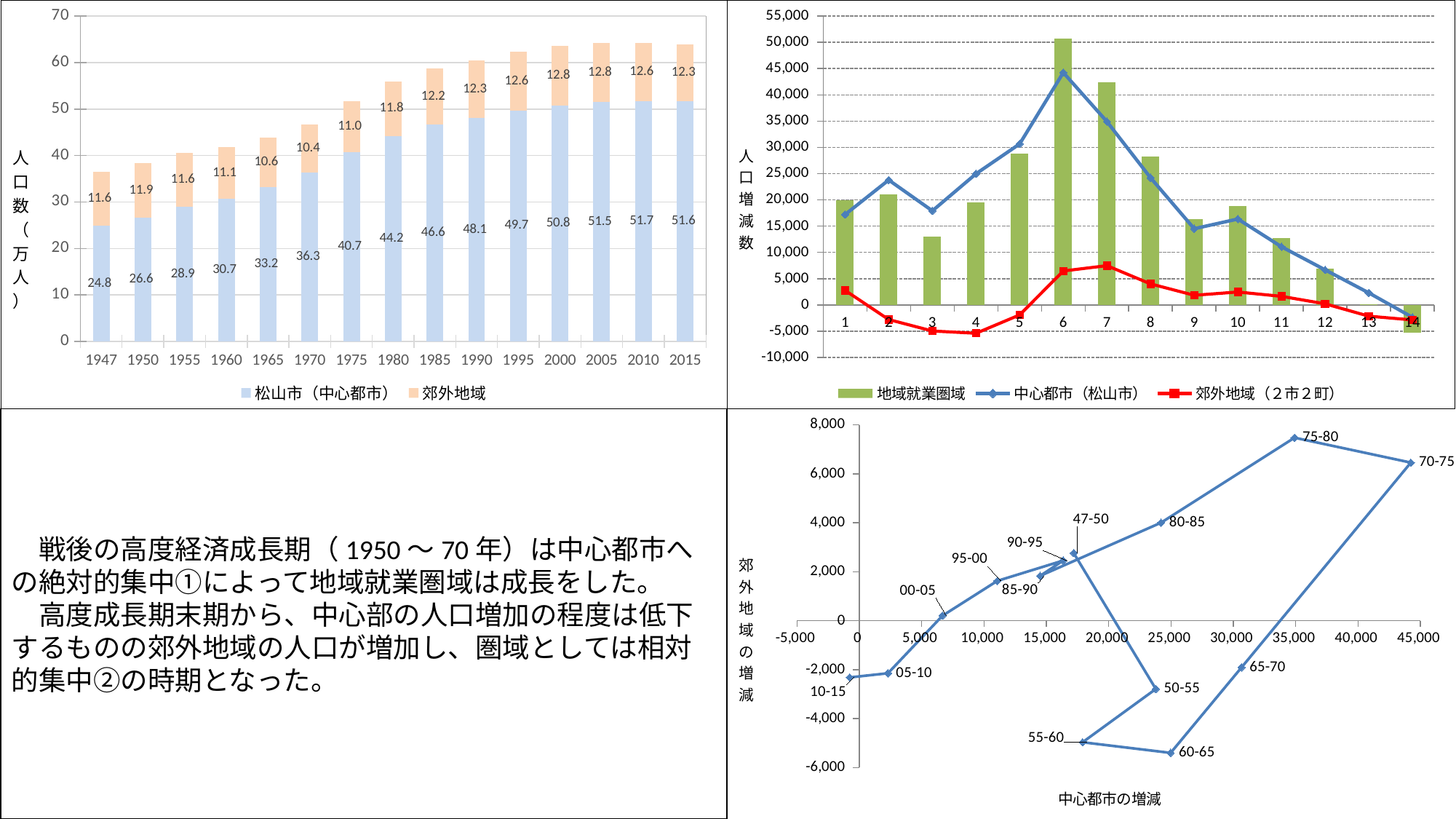
In the top-right chart, at which x-axis category is the 地域就業圏域 bar highest? 6 In the top-left chart, what is the value for 松山市（中心都市） in 1947? 24.8 In the top-left chart, what is the total of the stacked bar for 2015? 63.9 In the top-left chart, what is the difference between the 松山市（中心都市） values for 1975 and 1970? 4.4 In the top-right chart, is the 地域就業圏域 bar at category 7 greater or less than 40,000? greater In the top-left chart, in which year is the 松山市（中心都市） value highest? 2010 In the top-right chart, how many series does the legend list? 3 What kind of chart is the top-left chart? Stacked bar chart In the top-left chart, what is the value for 郊外地域 in 2000? 12.8 In the bottom-right chart, which labelled point has the highest value on the vertical axis (郊外地域の増減)? 75-80 In the top-left chart, how many years are shown on the x axis? 15 In the top-left chart, in which year is the 郊外地域 value lowest? 1970